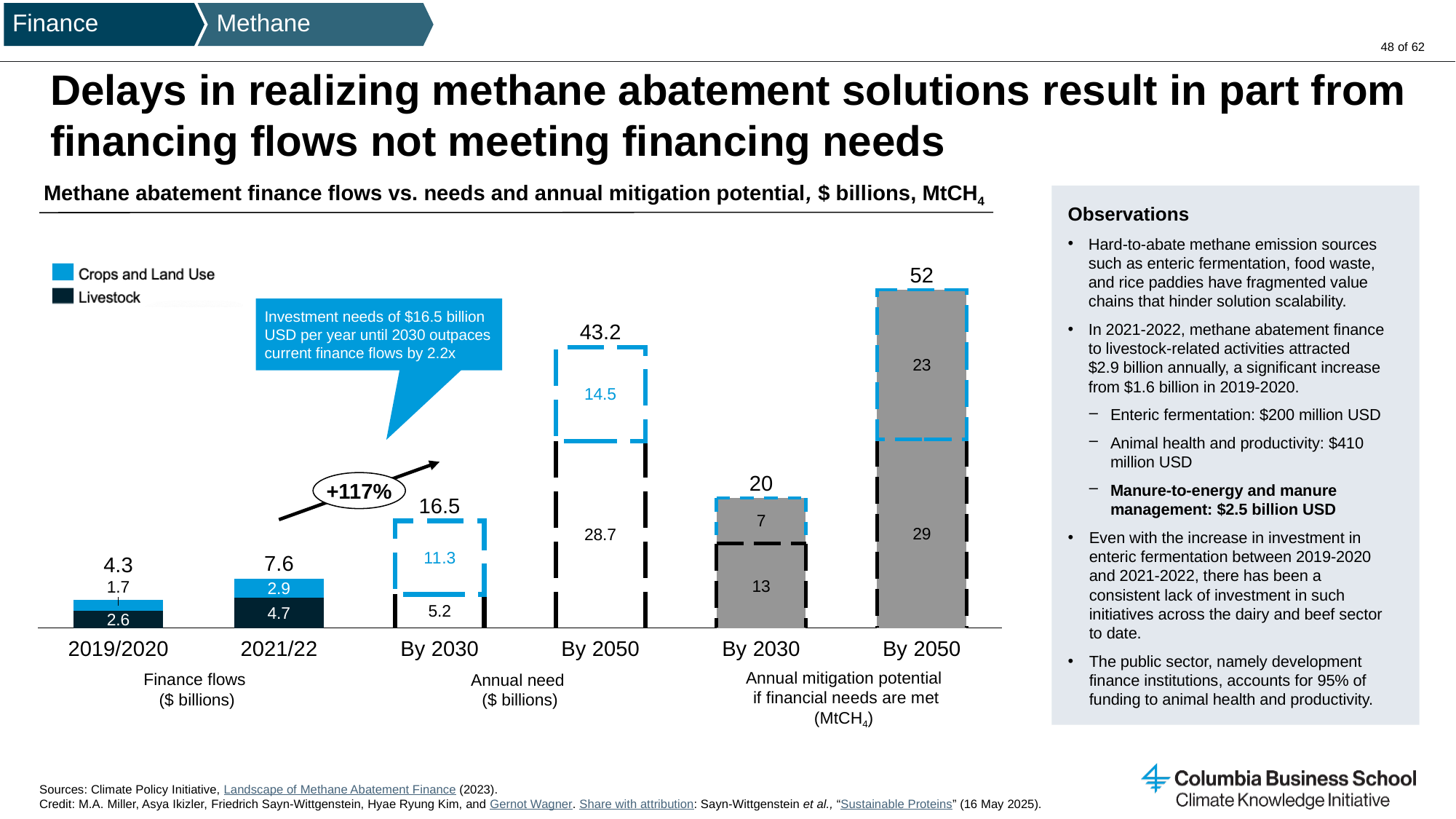
What is the total value of the 2021/22 finance flows bar? 7.6 What is the Livestock value in the 2019/2020 finance flows bar? 2.6 How many series does the legend list? 2 Which bar has the lowest total value? 2019/2020 What is the Crops and Land Use value in the 'By 2050' annual need bar? 14.5 What is the Livestock value in the 'By 2030' annual mitigation potential bar? 13 What is the difference between the total annual need by 2050 and by 2030? 26.7 What percentage increase is annotated between the 2021/22 finance flows and the 'By 2030' annual need? +117% What kind of chart is shown on the slide? Stacked bar chart How many bars are shown in the chart? 6 Which is larger in the 'By 2030' annual need bar: the Crops and Land Use value or the Livestock value? Crops and Land Use Which bar has the highest total value? By 2050 (Annual mitigation potential)